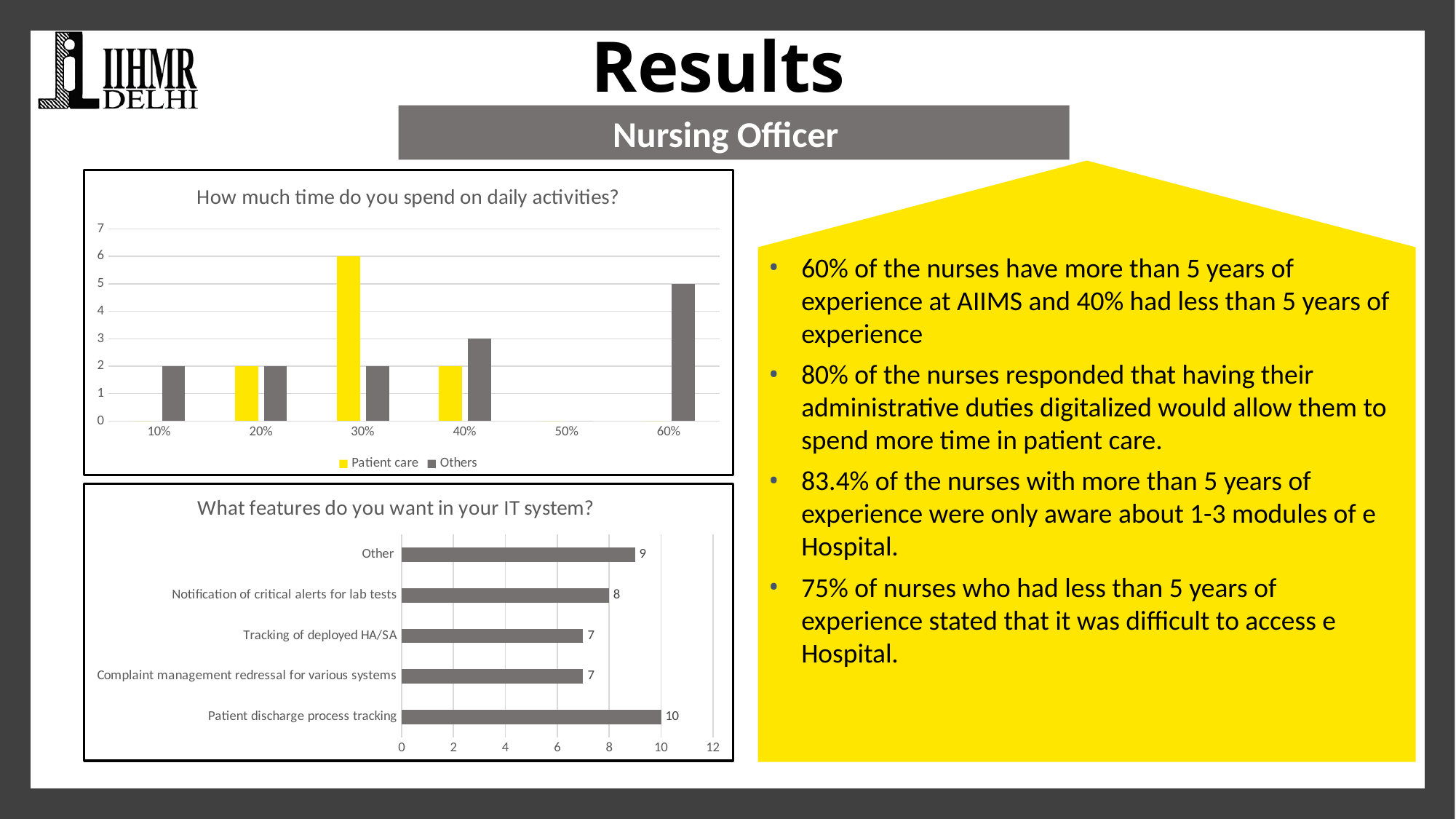
In the chart 'What features do you want in your IT system?', which feature has the highest value? Patient discharge process tracking In the chart 'What features do you want in your IT system?', what is the value for Patient discharge process tracking? 10 In the chart 'How much time do you spend on daily activities?', what is the value for Patient care at 30%? 6 In the chart 'How much time do you spend on daily activities?', what is the value for Others at 60%? 5 What type of chart is 'What features do you want in your IT system?'? Bar chart In the chart 'How much time do you spend on daily activities?', which is larger at 40%: Patient care or Others? Others In the chart 'What features do you want in your IT system?', what is the value for Notification of critical alerts for lab tests? 8 In the chart 'What features do you want in your IT system?', how many features are listed? 5 In the chart 'How much time do you spend on daily activities?', what colour are the Patient care bars? Yellow In the chart 'How much time do you spend on daily activities?', how many series does the legend list? 2 In the chart 'How much time do you spend on daily activities?', which category has the highest Patient care value? 30% In the chart 'What features do you want in your IT system?', what is the difference between Patient discharge process tracking and Tracking of deployed HA/SA? 3